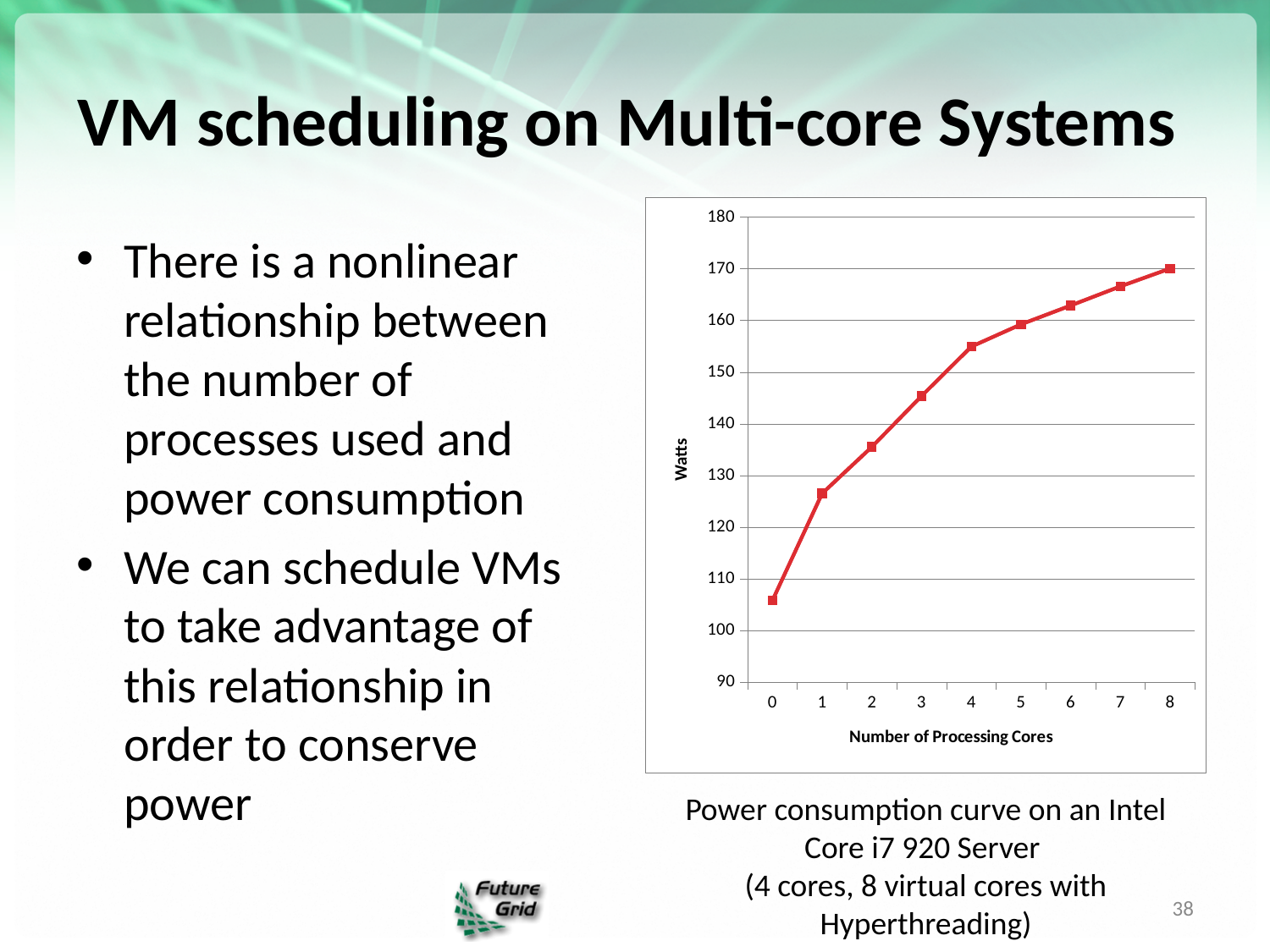
Is the value for 1 processing core greater or less than 120? greater How many data points are plotted on the line? 9 What is the label of the y axis of the chart? Watts Which has higher power consumption, 2 processing cores or 6 processing cores? 6 processing cores What kind of chart is shown on the slide? line chart Is the value for 0 processing cores greater or less than 110? less At which number of processing cores is power consumption lowest? 0 Is the value for 3 processing cores greater or less than 140? greater At which number of processing cores is power consumption highest? 8 What is the label of the x axis of the chart? Number of Processing Cores Do the values rise or fall as the number of processing cores increases? rise